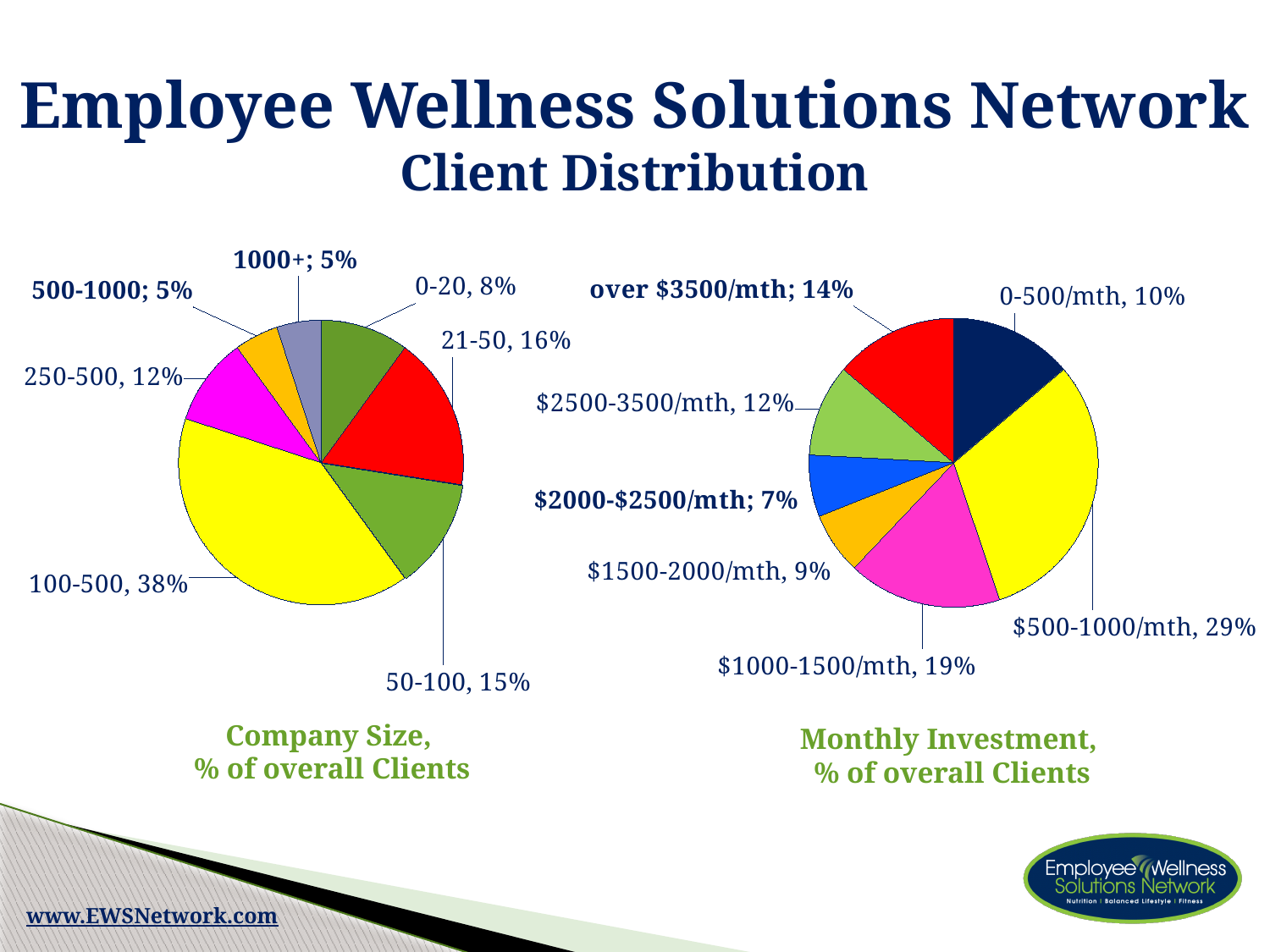
In the Company Size chart, which company size has the largest share of clients? 100-500 In the Monthly Investment chart, which investment range has the smallest share of clients? $2000-$2500/mth In the Monthly Investment chart, which is larger: the share for $1000-1500/mth or the share for $2500-3500/mth? $1000-1500/mth In the Company Size chart, what is the difference between the 21-50 share and the 0-20 share? 8% In the Monthly Investment chart, what is the difference between the $500-1000/mth share and the 0-500/mth share? 19% In the Company Size chart, how many company size categories are shown? 7 What type of chart is the Company Size chart on the left? pie chart In the Monthly Investment chart, what percentage of overall clients invest $500-1000/mth? 29% In the Company Size chart, what percentage of overall clients are companies of 100-500? 38% What is the title of the chart on the right? Monthly Investment, % of overall Clients In the Company Size chart, what percentage of overall clients are companies of 21-50? 16% In the Monthly Investment chart, what percentage of overall clients invest over $3500/mth? 14%